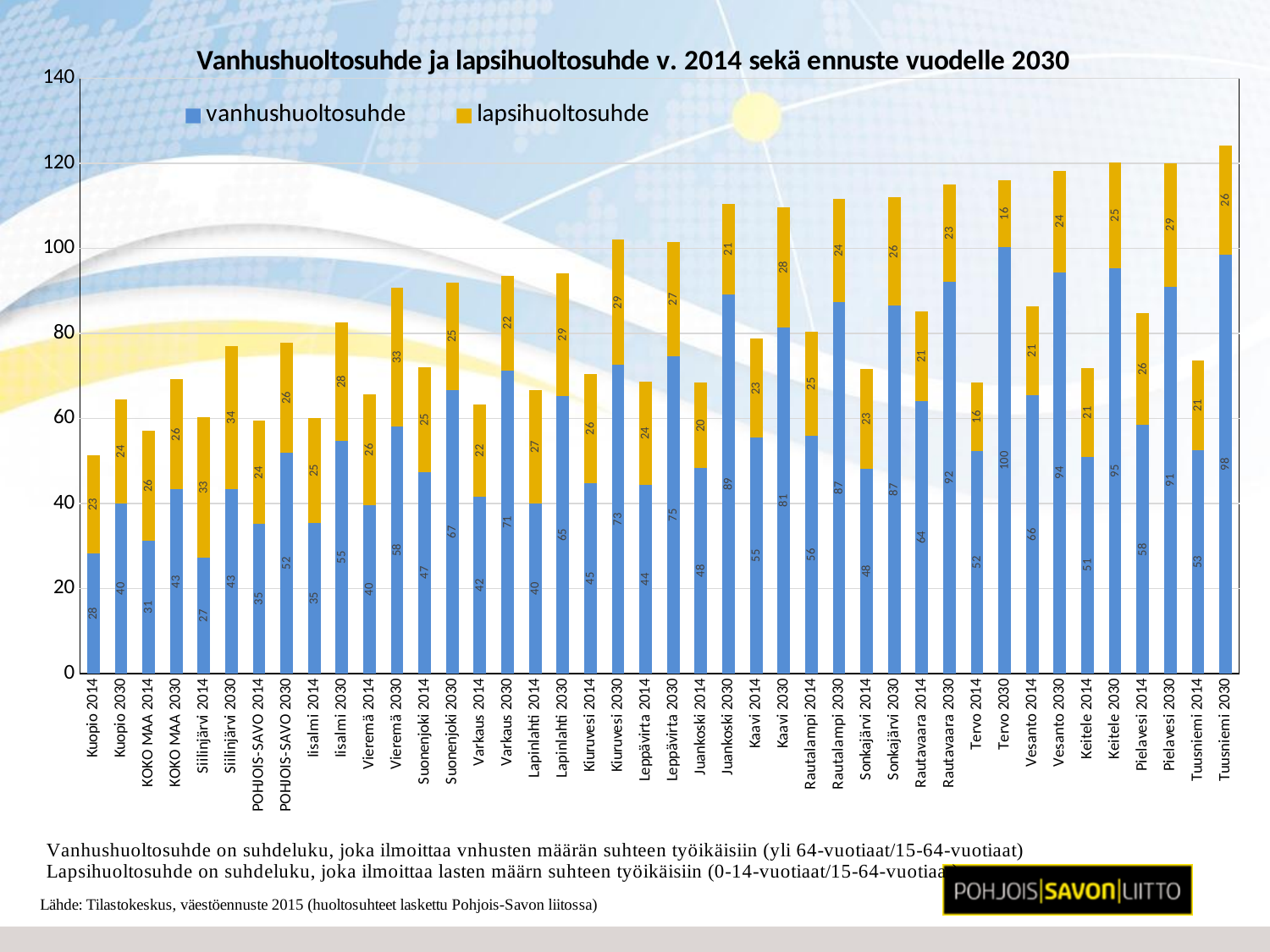
What is the total height of the stacked bar for Tuusniemi 2030? 124 What is the difference between the vanhushuoltosuhde values for Tervo 2030 and Tervo 2014? 48 How many categories are shown on the x axis? 42 What is the vanhushuoltosuhde value for Tervo 2030? 100 What is the total height of the stacked bar for Kuopio 2014? 51 How many series does the legend list? 2 Which category has the highest vanhushuoltosuhde value? Tervo 2030 Which is larger, the vanhushuoltosuhde for Juankoski 2030 or for Kaavi 2030? Juankoski 2030 What is the lapsihuoltosuhde value for Siilinjärvi 2030? 34 What kind of chart is shown on the slide? Stacked bar chart What is the vanhushuoltosuhde value for Kuopio 2014? 28 Which category has the lowest vanhushuoltosuhde value? Siilinjärvi 2014